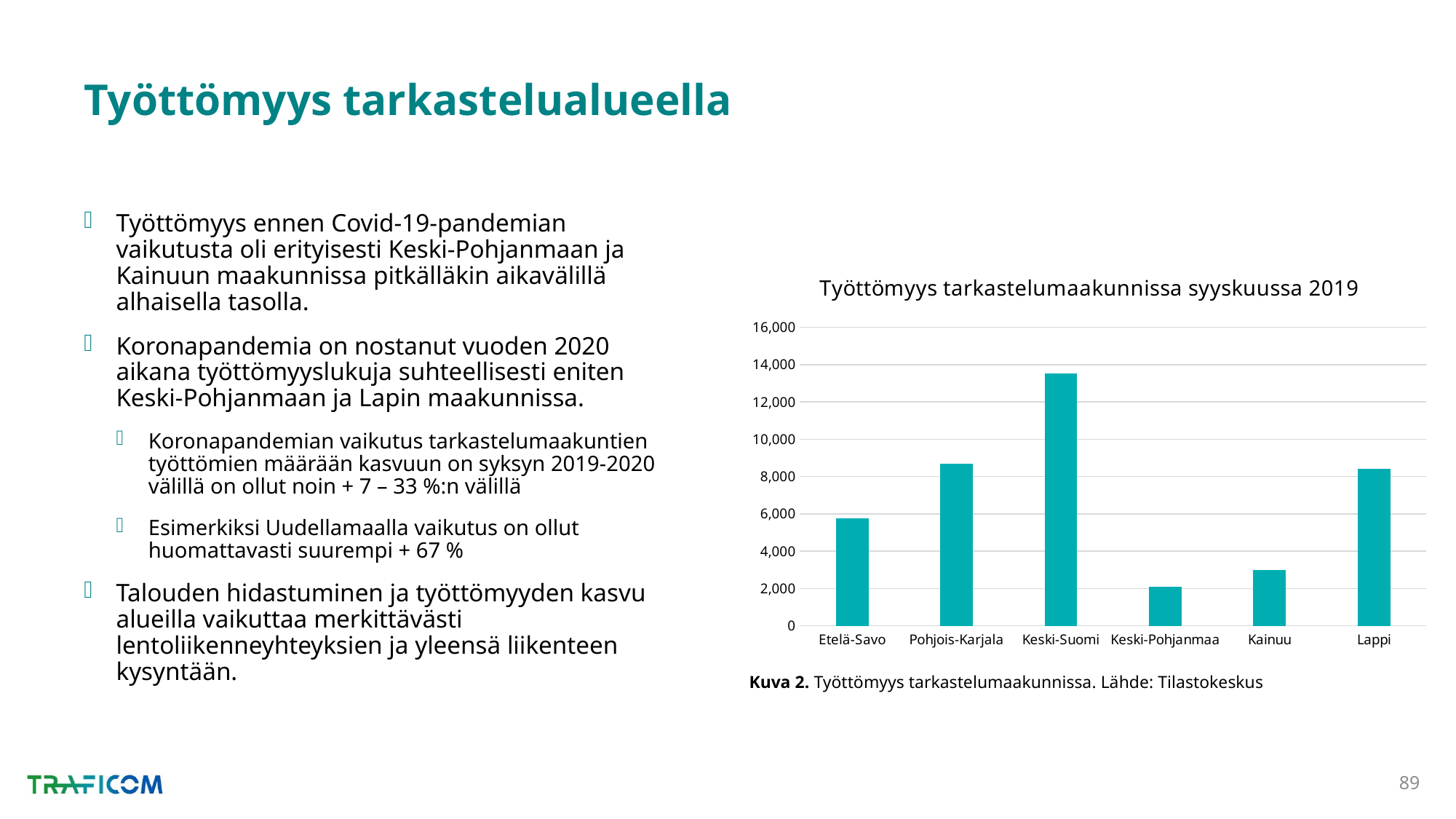
Is the value for Keski-Pohjanmaa greater or less than 4,000? less Which region has the lowest unemployment value in the chart? Keski-Pohjanmaa Is the value for Keski-Suomi greater or less than 12,000? greater Which has a larger value, Etelä-Savo or Pohjois-Karjala? Pohjois-Karjala What kind of chart is shown on the slide? bar chart How many regions (categories) are shown on the x axis of the chart? 6 What is the title of the chart? Työttömyys tarkastelumaakunnissa syyskuussa 2019 Is the value for Kainuu greater or less than 4,000? less Which region has the highest unemployment value in the chart? Keski-Suomi Which has a larger value, Kainuu or Keski-Pohjanmaa? Kainuu